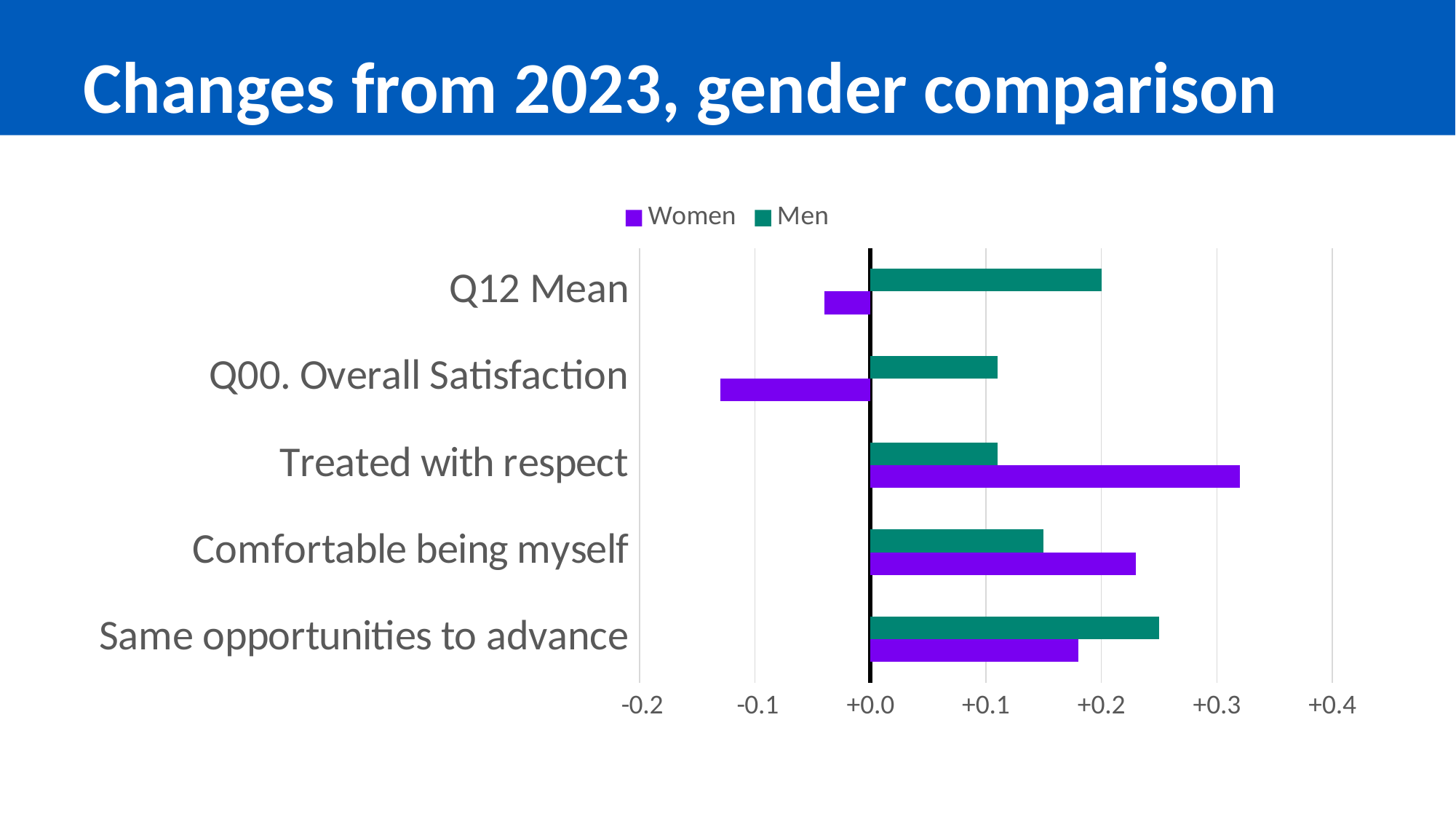
Which category has the lowest value for Women? Q00. Overall Satisfaction Is the value for Men in Comfortable being myself greater or less than +0.1? greater For Q12 Mean, which is larger, the value for Women or the value for Men? Men For Same opportunities to advance, which is larger, the value for Women or the value for Men? Men Which category has the highest value for Men? Same opportunities to advance Is the value for Women in Treated with respect greater or less than +0.3? greater What colour represents the Women series in the chart? purple Which category has the highest value for Women? Treated with respect What kind of chart is shown on the slide? bar chart How many series does the legend list? 2 How many categories are shown on the chart? 5 Is the value for Women in Q00. Overall Satisfaction greater or less than -0.1? less